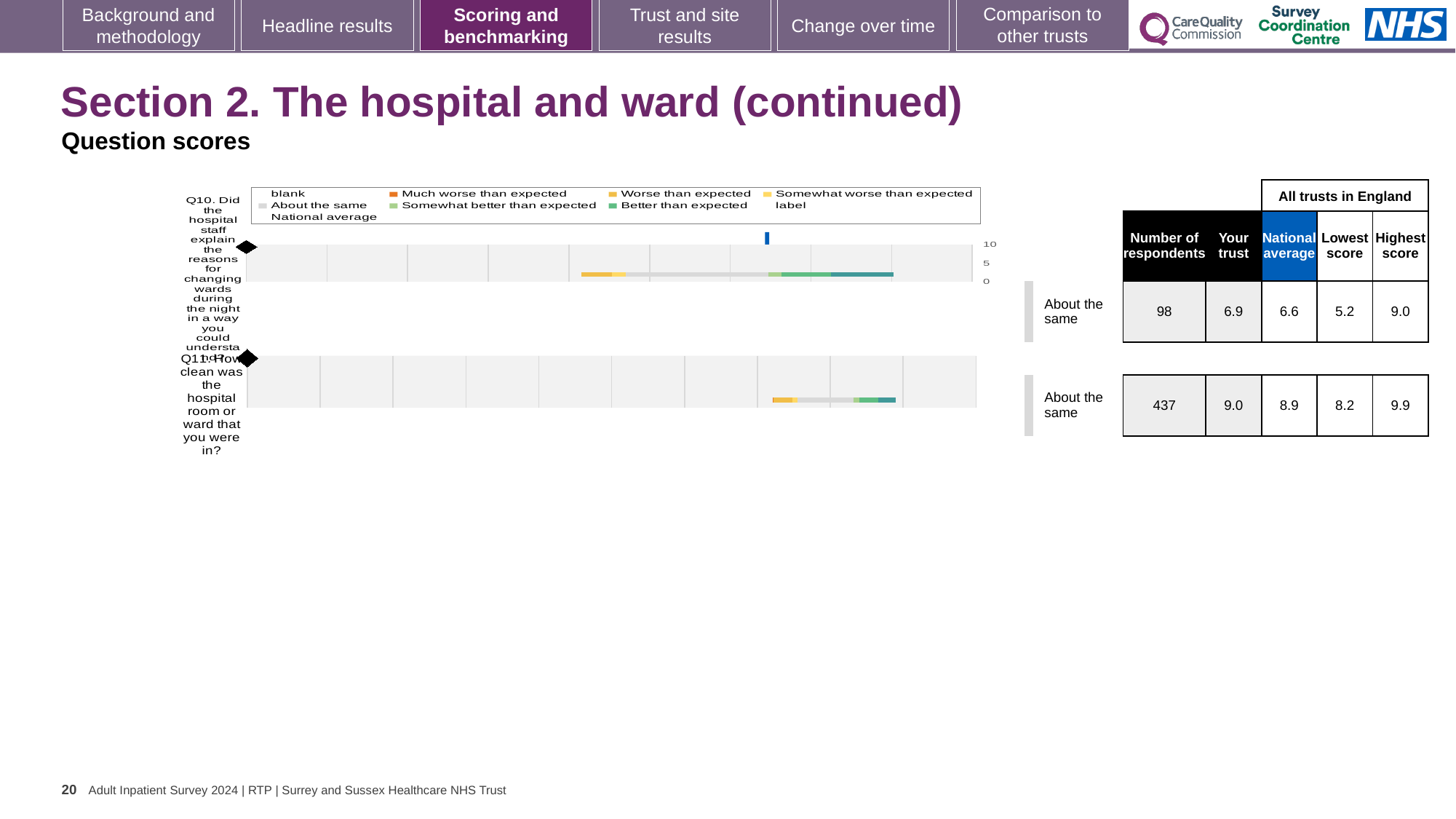
Which question does the top chart on the slide relate to? Q10 How many respondents are shown for Q11? 437 Which question has more respondents, Q10 or Q11? Q11 What is the lowest score across all trusts in England for Q10? 5.2 What kind of chart is used to show the question scores for Q10 and Q11? bar chart For Q10, which is higher: the 'Your trust' score or the national average? Your trust For Q11, what is the difference between the highest score and the lowest score across all trusts in England? 1.7 What benchmark category is shown next to the Q10 chart? About the same For Q11 (how clean was the hospital room or ward), what is the 'Your trust' score shown? 9.0 How many survey questions are plotted on the slide? 2 For Q10 (did staff explain the reasons for changing wards during the night), what is the national average score? 6.6 For Q11, what is the difference between the 'Your trust' score and the national average? 0.1